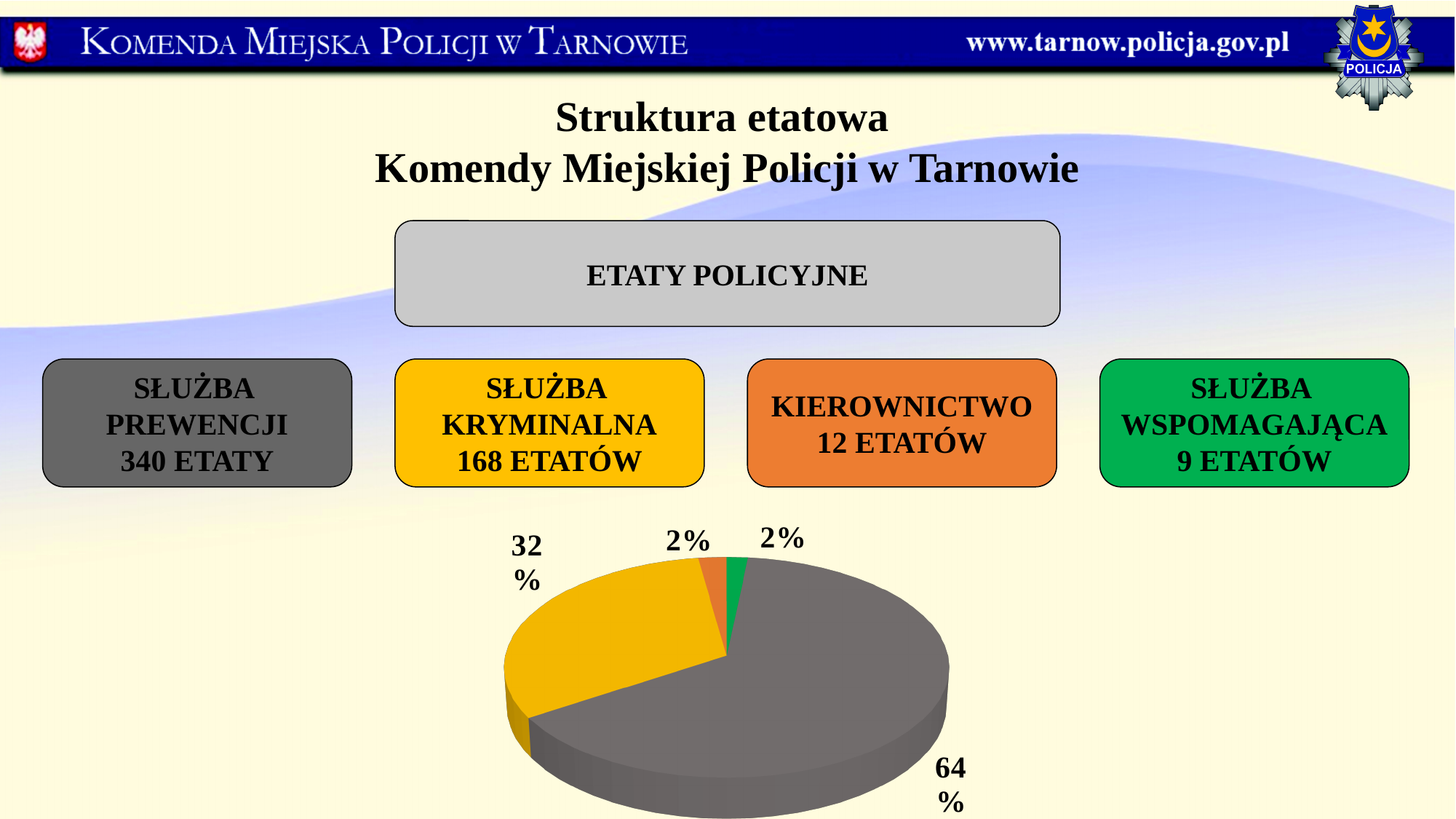
How many posts (etaty) does the box for Służba Prewencji show? 340 What percentage is shown for the largest (grey) slice of the pie chart? 64% What is the difference in percentage points between the grey slice and the yellow slice? 32 What percentage is shown for the green slice of the pie chart? 2% How many posts (etaty) does the box for Służba Kryminalna show? 168 Which is larger in the pie chart, the grey slice or the yellow slice? grey Which colour slice is the largest in the pie chart? grey What type of chart is shown on the slide? pie chart What percentage is shown for the orange slice of the pie chart? 2% Is the share of the grey slice greater or less than 50%? greater How many slices does the pie chart have? 4 What percentage is shown for the yellow slice of the pie chart? 32%